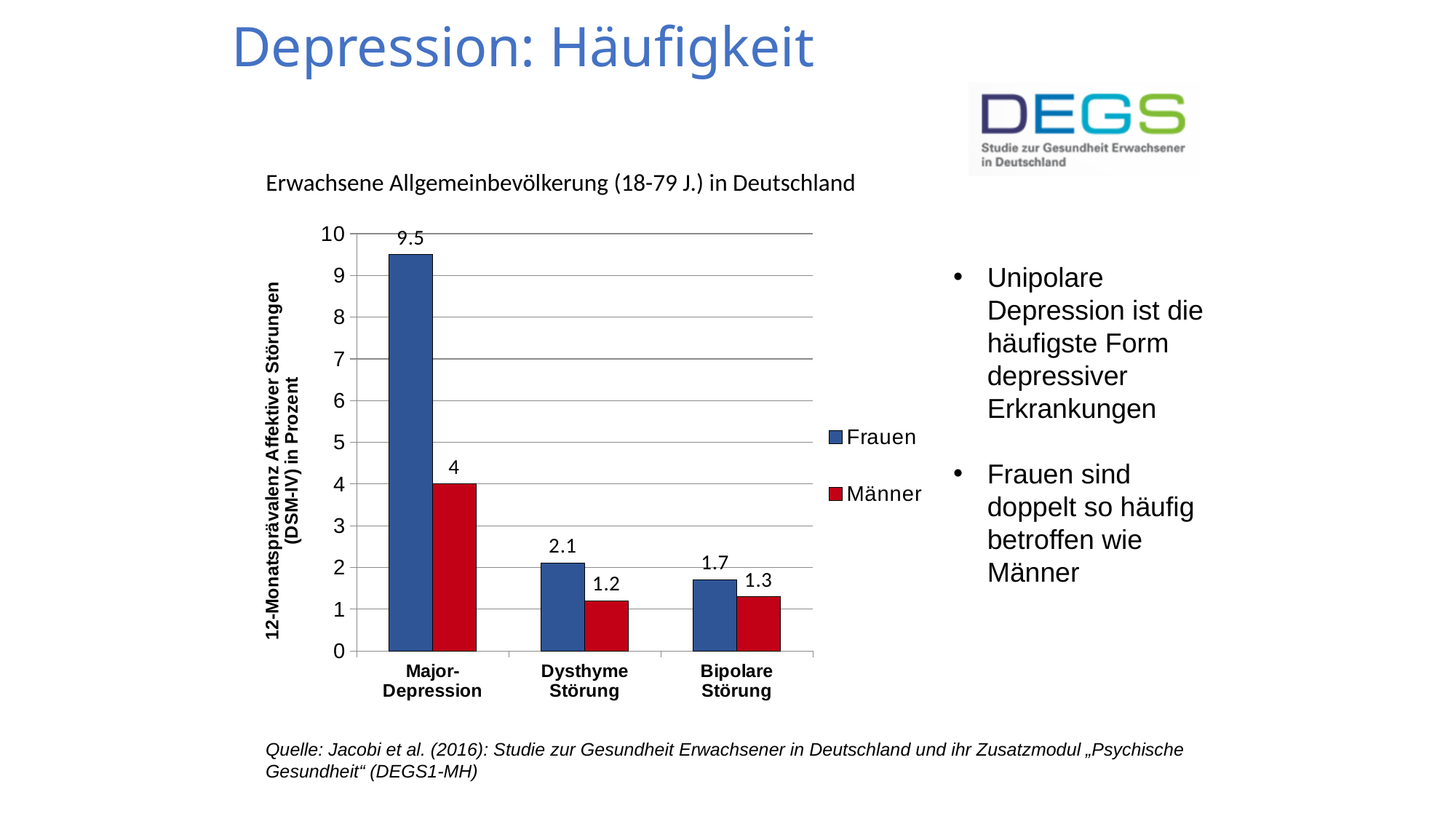
What is the value for Frauen in the Major-Depression category? 9.5 How many categories are shown on the x axis? 3 Which category has the lowest value for Männer? Dysthyme Störung Which is larger for Bipolare Störung, the Frauen value or the Männer value? Frauen What is the value for Frauen in the Bipolare Störung category? 1.7 Which category has the highest value for Frauen? Major-Depression What is the difference between the Frauen and Männer values for Major-Depression? 5.5 Is the value for Männer in the Major-Depression category greater or less than 5? less What kind of chart is shown on the slide? bar chart What is the label of the y axis? 12-Monatsprävalenz Affektiver Störungen (DSM-IV) in Prozent What is the value for Männer in the Dysthyme Störung category? 1.2 How many series does the legend list? 2